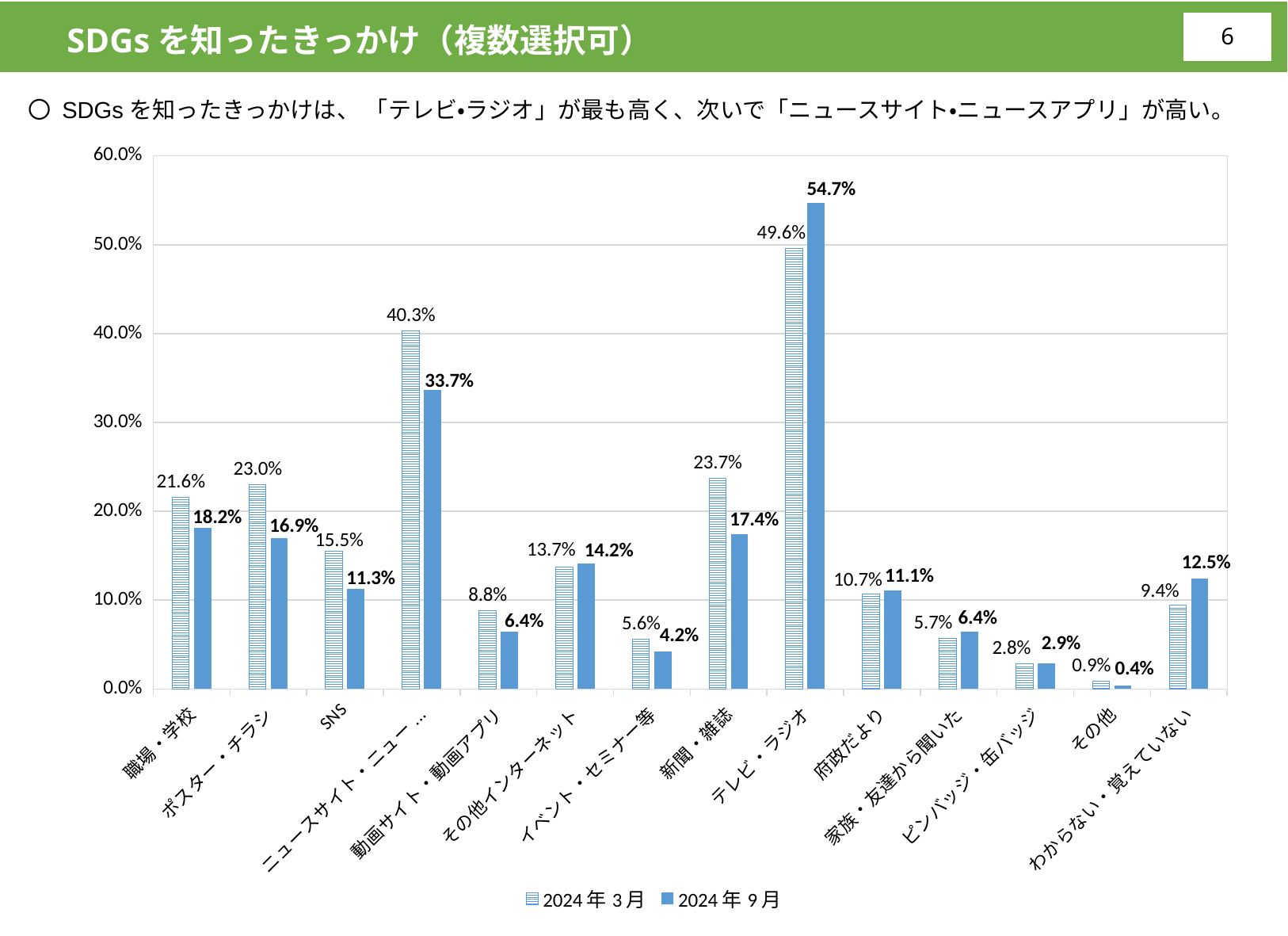
Which category has the highest value in the 2024年9月 series? テレビ・ラジオ For わからない・覚えていない, which series has the larger value, 2024年3月 or 2024年9月? 2024年9月 How many categories are shown on the x axis? 14 Which category has the lowest value in the 2024年3月 series? その他 What is the difference between the 2024年9月 and 2024年3月 values for テレビ・ラジオ? 5.1% How many series does the legend list? 2 What is the difference between the 2024年3月 and 2024年9月 values for 職場・学校? 3.4% Is the 2024年3月 value for ポスター・チラシ greater or less than 20.0%? greater What is the value for SNS in the 2024年3月 series? 15.5% What is the value for テレビ・ラジオ in the 2024年9月 series? 54.7% What is the value for 新聞・雑誌 in the 2024年9月 series? 17.4% What kind of chart is shown on the slide? bar chart